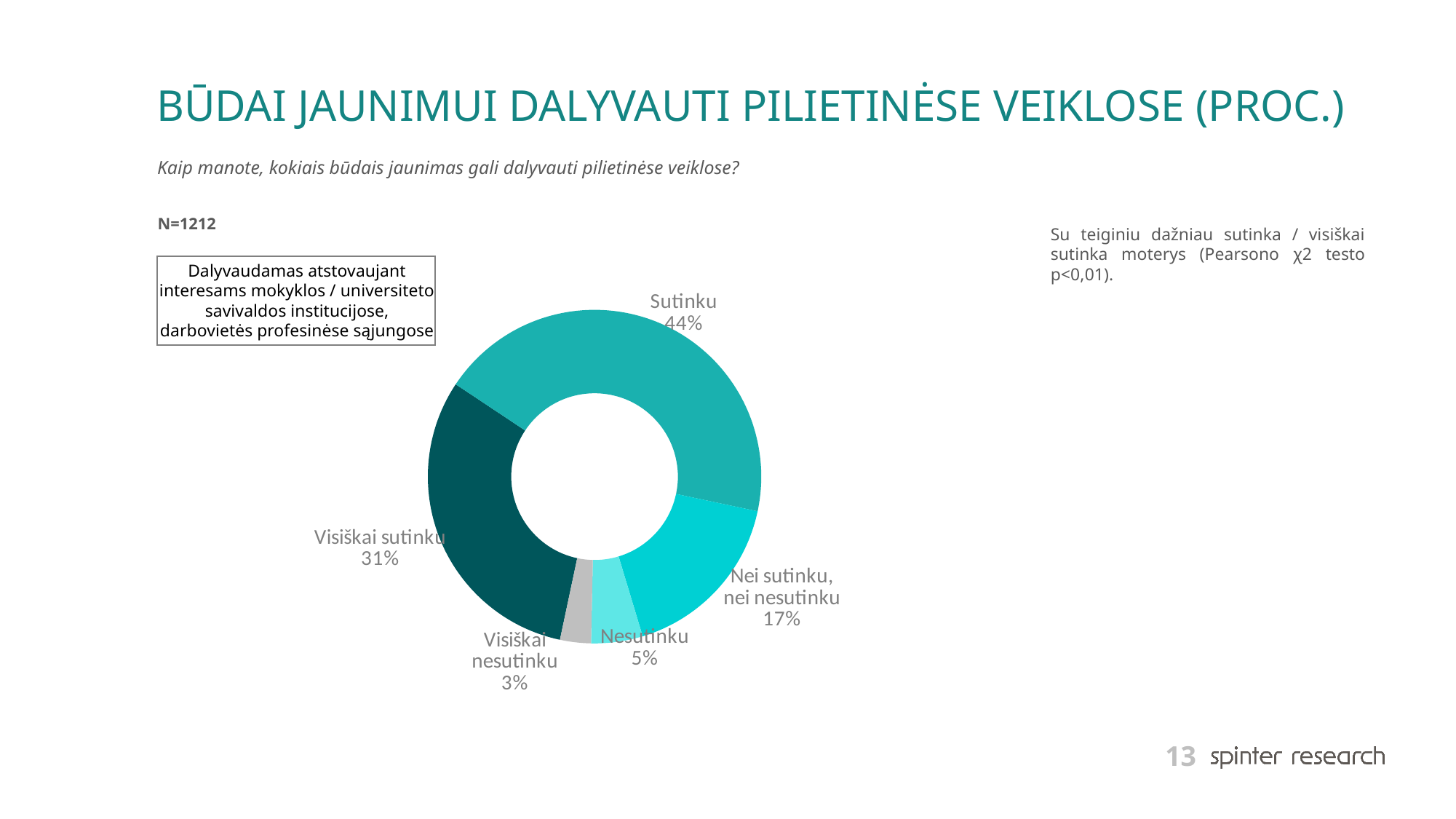
What percentage of respondents answered 'Nesutinku'? 5% What percentage of respondents answered 'Nei sutinku, nei nesutinku'? 17% What percentage of respondents answered 'Visiškai nesutinku'? 3% Which response category has the largest share? Sutinku Which response category has the smallest share? Visiškai nesutinku What is the difference in percentage points between 'Sutinku' and 'Visiškai sutinku'? 13 What percentage of respondents answered 'Visiškai sutinku'? 31% Which is larger, the share for 'Nei sutinku, nei nesutinku' or the share for 'Nesutinku'? Nei sutinku, nei nesutinku What kind of chart is shown on the slide? Doughnut (pie) chart What is the sample size (N) stated on the slide? N=1212 What percentage of respondents answered 'Sutinku'? 44% How many response categories are shown in the chart? 5